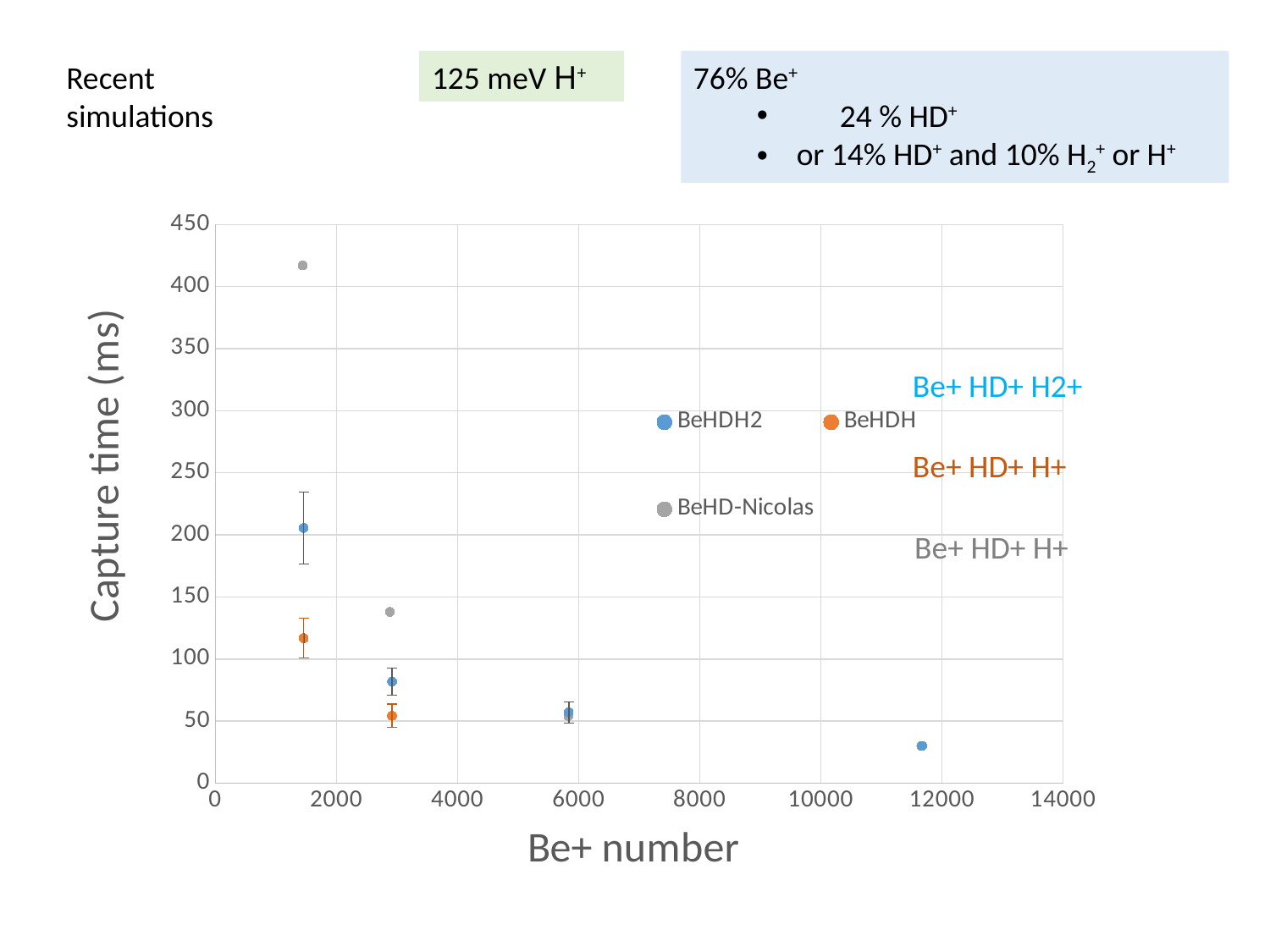
Is the capture time of the BeHD-Nicolas point near Be+ number 1500 greater or less than 400? greater Which series contains the point with the highest capture time? BeHD-Nicolas What kind of chart is shown on the slide? scatter chart Does the capture time for the BeHDH2 series rise or fall as Be+ number increases? fall Is the capture time of the BeHDH2 point near Be+ number 11700 greater or less than 50? less How many series does the chart legend list? 3 What is the title of the x axis of the chart? Be+ number Is the capture time of the BeHDH2 point near Be+ number 2900 greater or less than 100? less What is the title of the y axis of the chart? Capture time (ms)